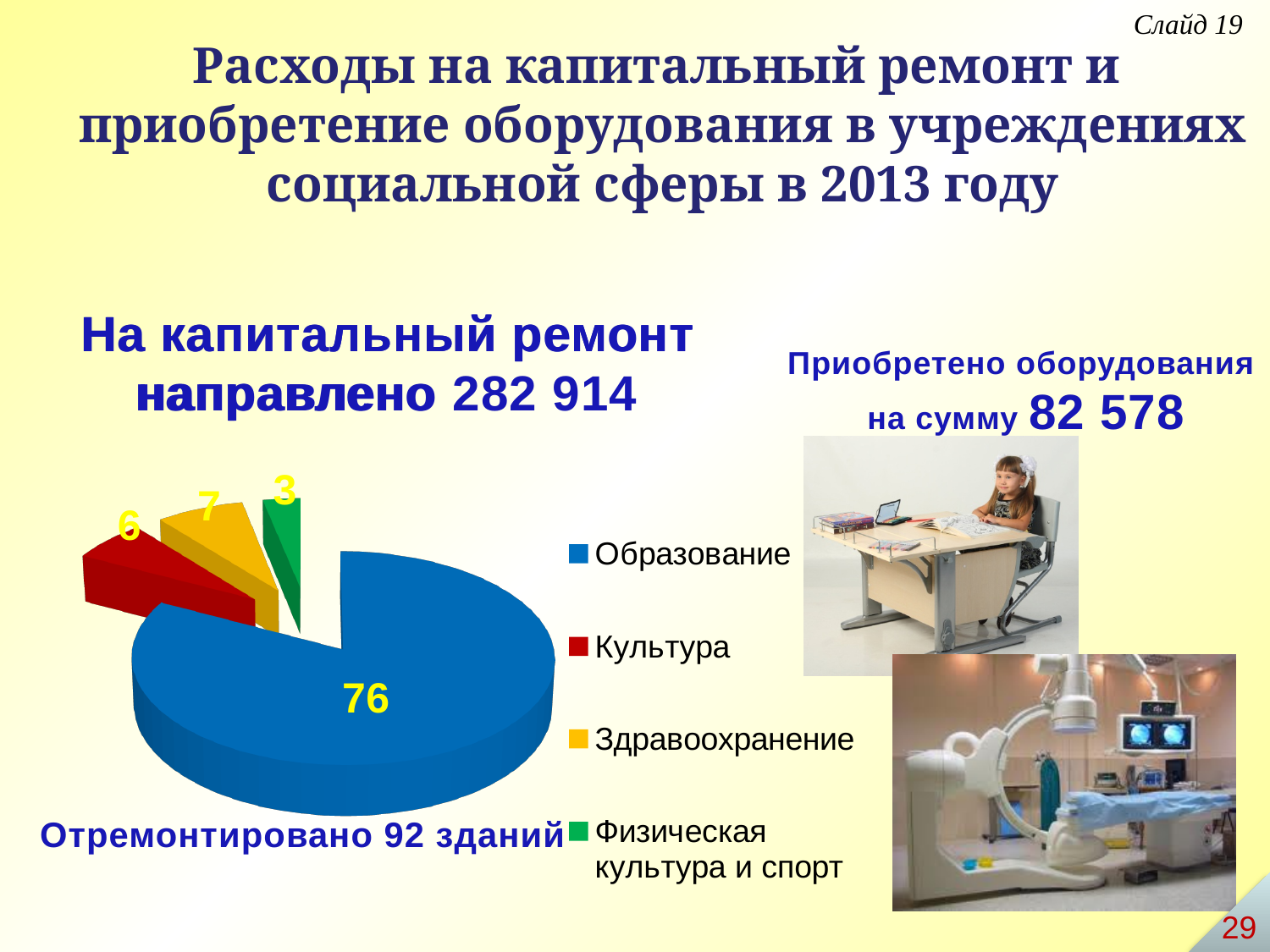
What is the value for Здравоохранение in the pie chart? 7 What colour is the slice for Культура in the pie chart? Red What is the difference between the values for Образование and Здравоохранение? 69 Which category has the smallest slice in the pie chart? Физическая культура и спорт What is the value for Образование in the pie chart? 76 What is the value for Культура in the pie chart? 6 What is the value for Физическая культура и спорт in the pie chart? 3 What is the sum of all the slice values in the pie chart? 92 Which category has the largest slice in the pie chart? Образование Which is larger, the value for Здравоохранение or the value for Культура? Здравоохранение How many categories does the pie chart have? 4 What kind of chart is shown on the slide? Pie chart